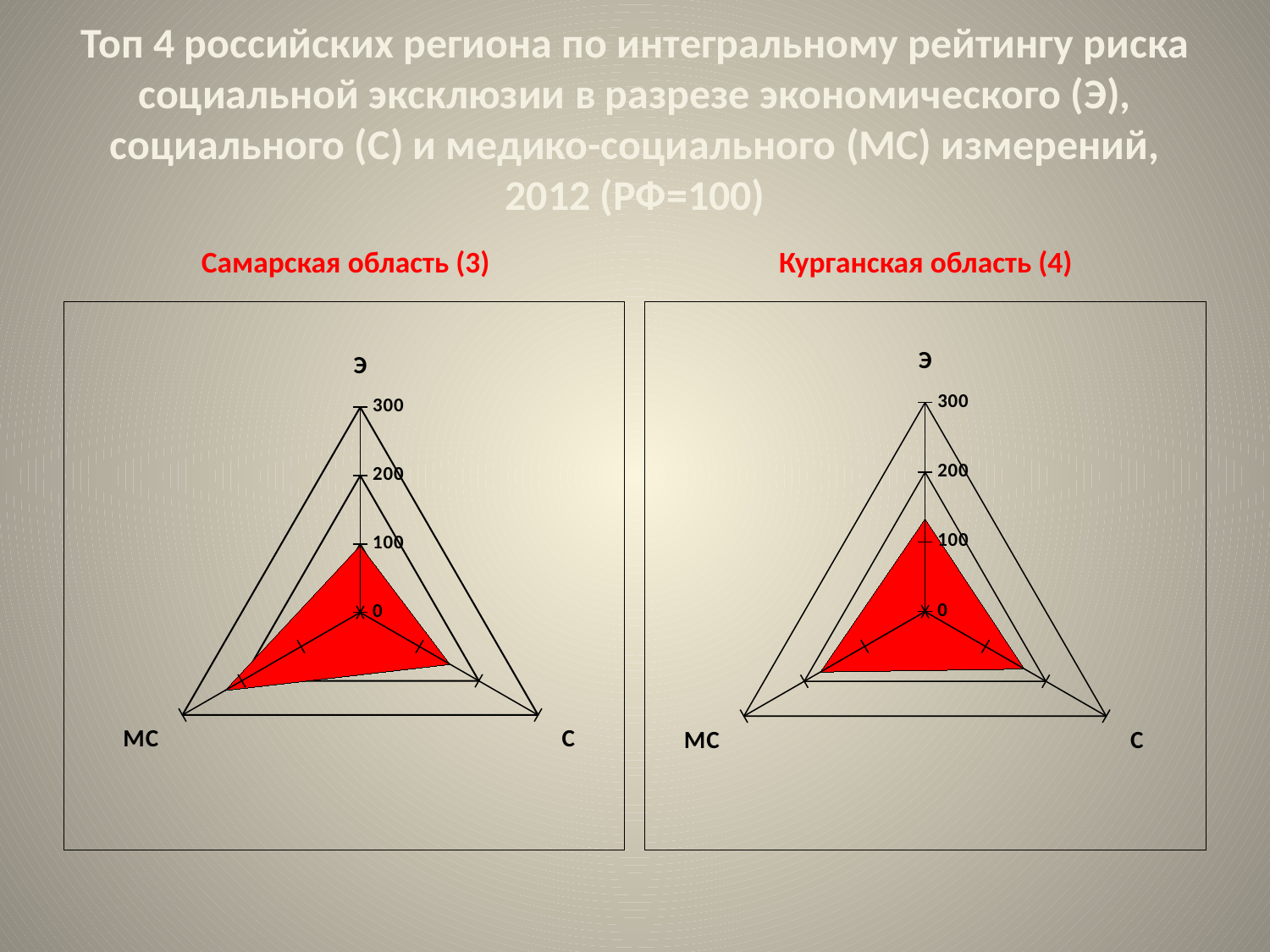
In the Самарская область (3) chart, which dimension has the lowest value? Э What is the highest tick value shown on the axes of the Курганская область (4) chart? 300 How many axes (dimensions) does the Самарская область (3) chart have? 3 What kind of chart is shown for Курганская область (4)? radar chart In the Курганская область (4) chart, is the value for МС greater or less than 200? less In the Курганская область (4) chart, is the value for С greater or less than 100? greater In the Самарская область (3) chart, is the value for С greater or less than 100? greater In the Курганская область (4) chart, which dimension has the lowest value? Э What kind of chart is shown for Самарская область (3)? radar chart In the Самарская область (3) chart, which dimension has the highest value? МС